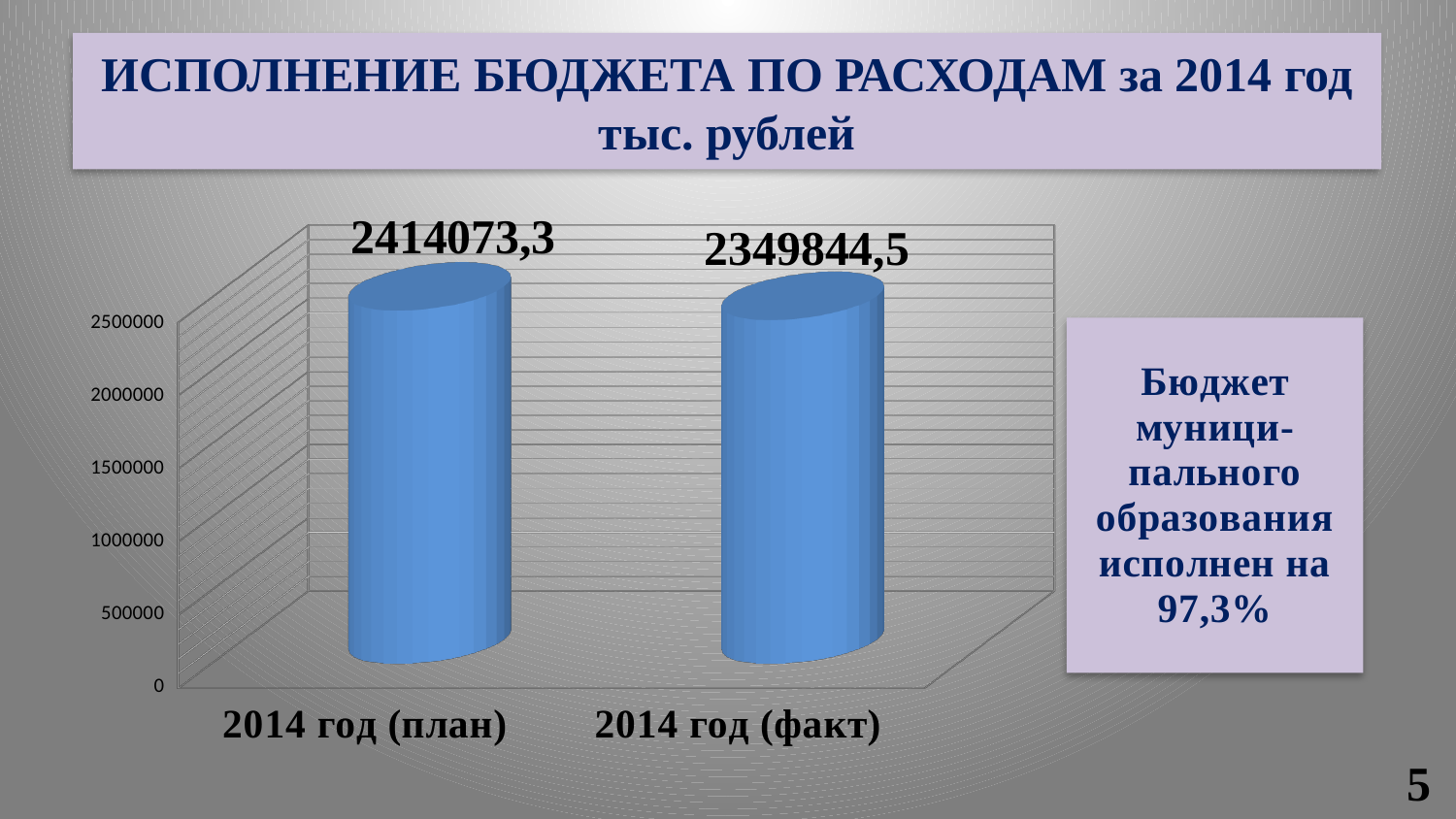
Is the value for 2014 год (план) greater or less than 2500000? less Is the value for 2014 год (факт) greater or less than 2000000? greater What is the value for 2014 год (факт)? 2349844,5 How many categories are shown on the chart? 2 Which is larger, the value for 2014 год (план) or the value for 2014 год (факт)? 2014 год (план) What is the title of the slide containing the chart? ИСПОЛНЕНИЕ БЮДЖЕТА ПО РАСХОДАМ за 2014 год тыс. рублей Do the values rise or fall from 2014 год (план) to 2014 год (факт)? fall Which category has the lowest value? 2014 год (факт) What is the value for 2014 год (план)? 2414073,3 What is the difference between the value for 2014 год (план) and the value for 2014 год (факт)? 64228,8 What kind of chart is shown on the slide? bar chart Which category has the highest value? 2014 год (план)